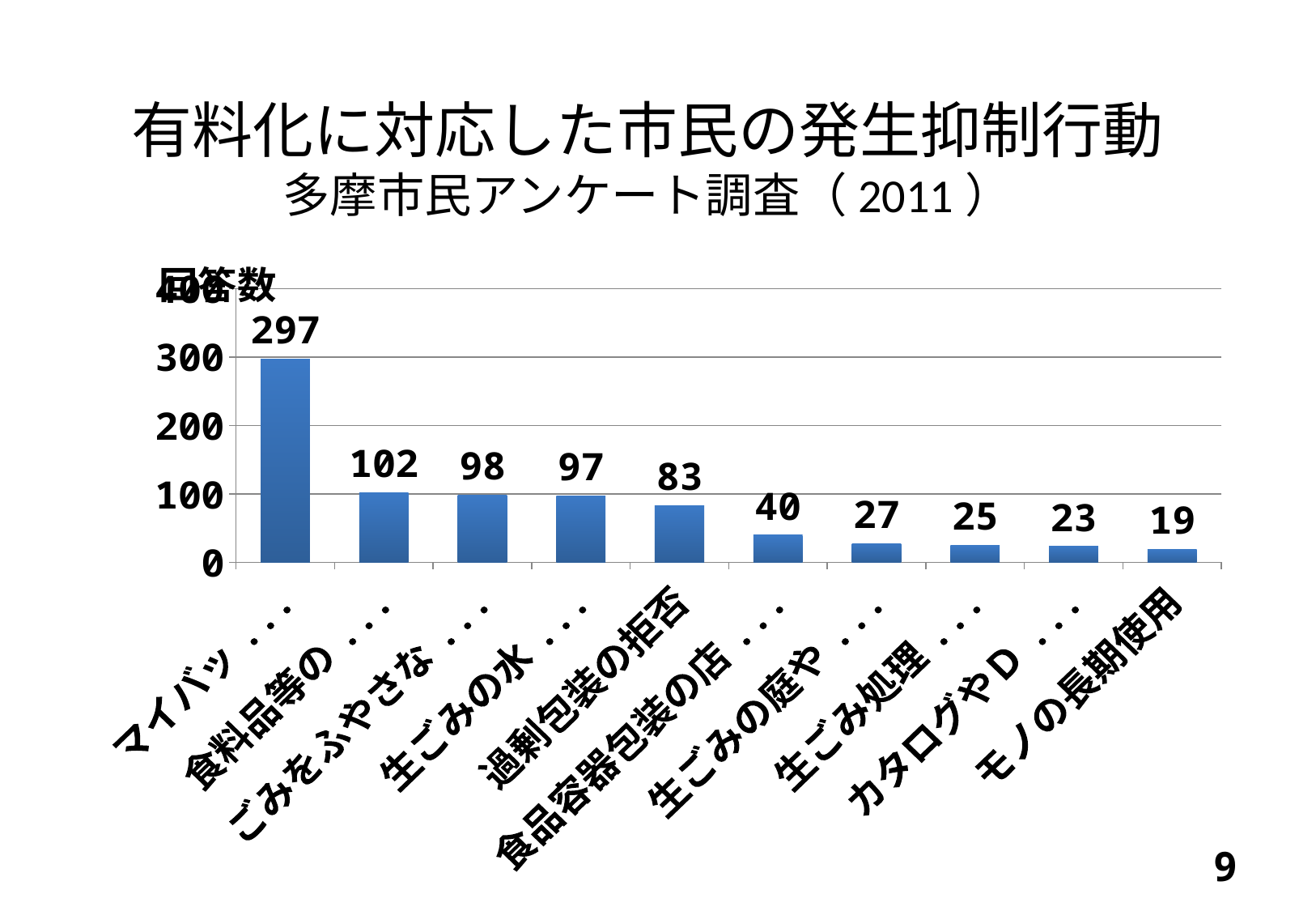
What is the difference between the value for 過剰包装の拒否 and the value for モノの長期使用? 64 What is the value for 過剰包装の拒否? 83 Which is larger, the value for 過剰包装の拒否 or the value for the bar labelled 生ごみ処理…? 過剰包装の拒否 Which category has the lowest value? モノの長期使用 What type of chart is shown on the slide? bar chart Is the value for the leftmost bar (マイバッ…) greater or less than 200? greater What is the value for モノの長期使用? 19 What is the value of the first (leftmost) bar, labelled マイバッ…? 297 How many categories (bars) are plotted in the chart? 10 Which category has the highest value? マイバッ… (the leftmost bar) Do the bar values rise or fall from left to right along the x axis? fall What is the label on the vertical axis of the chart? 回答数